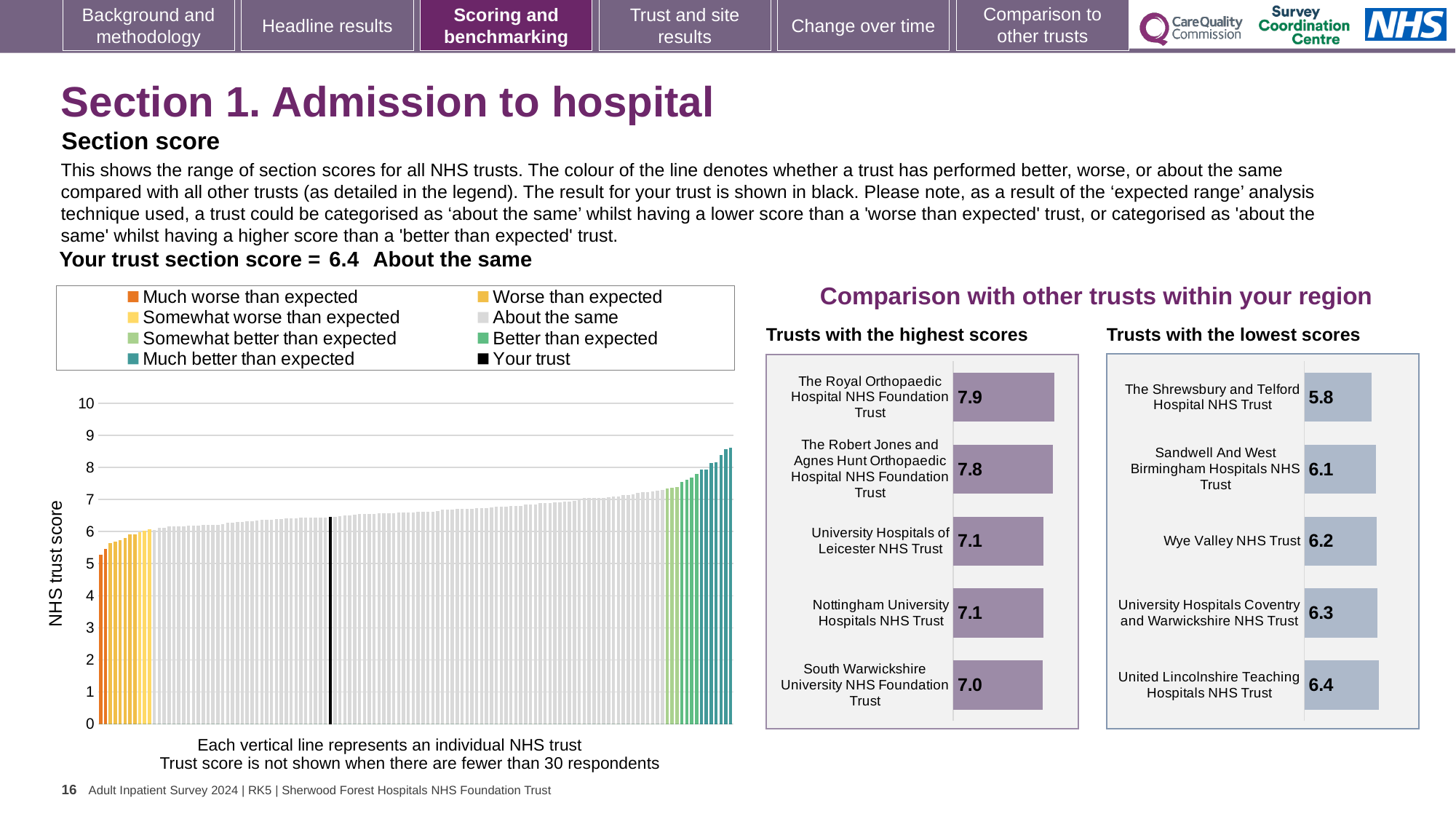
In the 'Trusts with the lowest scores' chart, what is the difference between the scores of United Lincolnshire Teaching Hospitals NHS Trust and The Shrewsbury and Telford Hospital NHS Trust? 0.6 How many trusts are listed in the 'Trusts with the highest scores' chart? 5 In the 'Trusts with the highest scores' chart, what is the difference between the scores of The Royal Orthopaedic Hospital NHS Foundation Trust and The Robert Jones and Agnes Hunt Orthopaedic Hospital NHS Foundation Trust? 0.1 How many entries does the legend of the main chart on the left list? 8 In the 'Trusts with the highest scores' chart, which trust has the lowest score? South Warwickshire University NHS Foundation Trust In the 'Trusts with the lowest scores' chart, which has the larger score: Wye Valley NHS Trust or Sandwell And West Birmingham Hospitals NHS Trust? Wye Valley NHS Trust In the main chart on the left showing all NHS trusts, do the trust scores rise or fall from left to right? rise In the 'Trusts with the lowest scores' chart, what is the score for The Shrewsbury and Telford Hospital NHS Trust? 5.8 In the 'Trusts with the highest scores' chart, what is the score for The Royal Orthopaedic Hospital NHS Foundation Trust? 7.9 In the main chart on the left showing all NHS trusts, what is the section score for your trust (the black line)? 6.4 In the 'Trusts with the highest scores' chart, what is the score for South Warwickshire University NHS Foundation Trust? 7.0 In the 'Trusts with the lowest scores' chart, which trust has the highest score? United Lincolnshire Teaching Hospitals NHS Trust